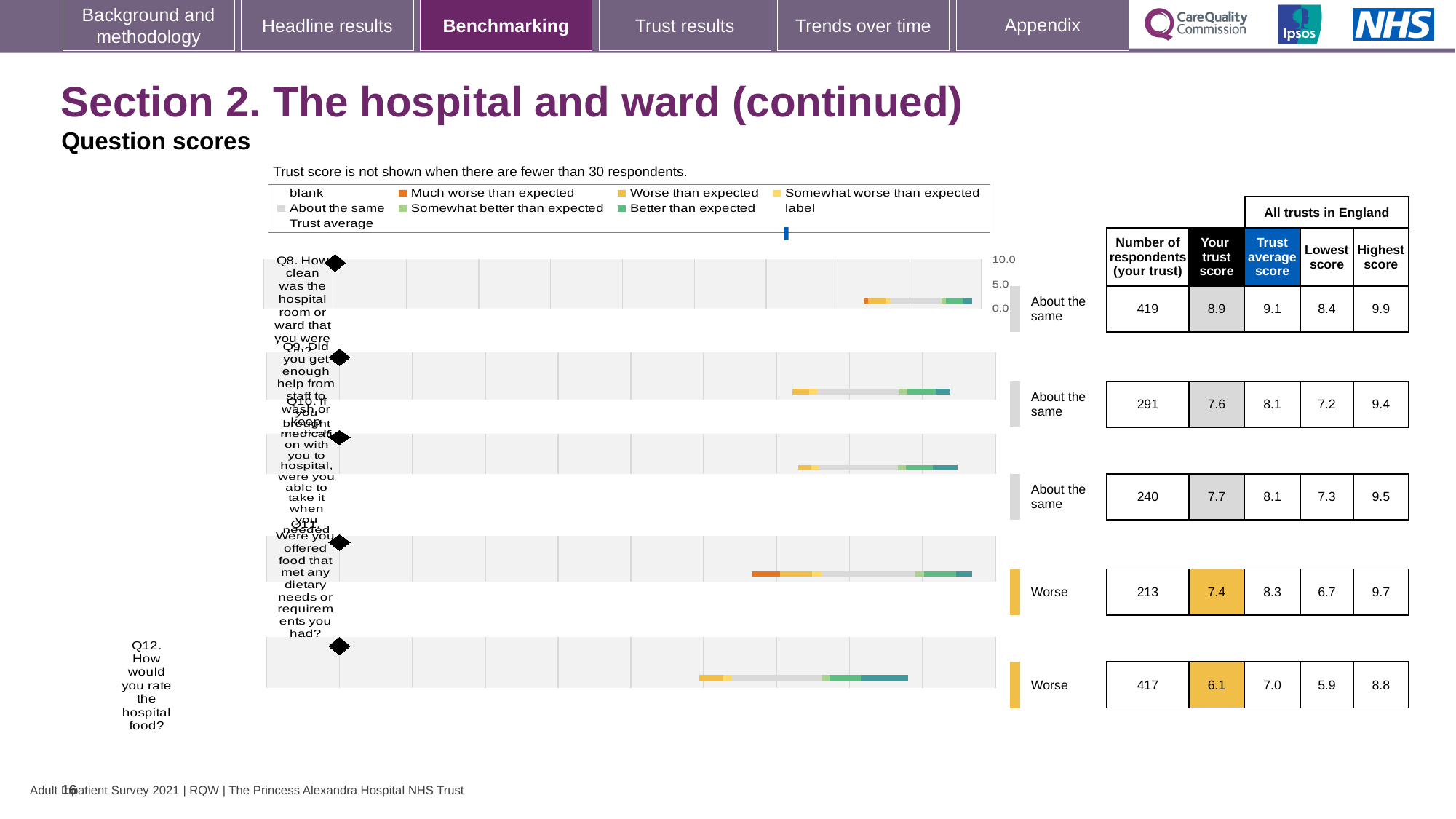
How many questions are shown on the chart? 5 What is the 'Your trust score' for Q8 (How clean was the hospital room or ward)? 8.9 What kind of chart is used to show the question scores? Bar chart Which question has the lowest 'Your trust score'? Q12 What is the trust average score for Q11 (Were you offered food that met any dietary needs or requirements you had)? 8.3 For Q12, what is the difference between the trust average score and your trust score? 0.9 What is the lowest score across all trusts in England for Q8? 8.4 Which question has the highest 'Your trust score'? Q8 How many respondents from your trust answered Q12 (How would you rate the hospital food)? 417 What benchmark category label is shown for Q11? Worse What is the highest score across all trusts in England for Q10? 9.5 For Q9, which is larger: your trust score or the trust average score? Trust average score